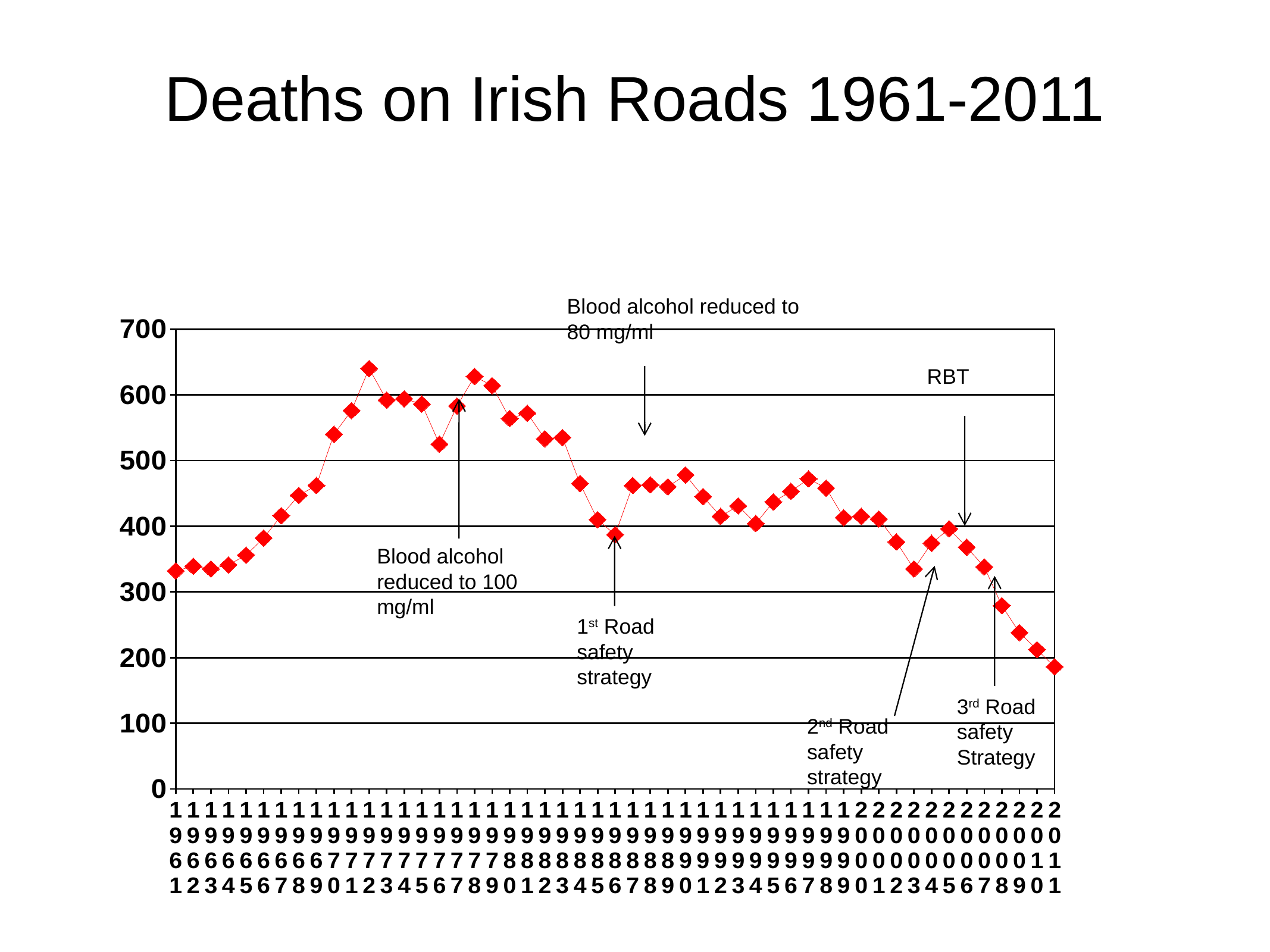
Is the value for 1972 greater or less than 600? greater Which year has the higher value, 1976 or 1978? 1978 Is the value for 1980 greater or less than 500? greater Which annotation on the chart points to the year 2006? RBT What is the title of the chart? Deaths on Irish Roads 1961-2011 Is the value for 2011 greater or less than 300? less Do the values rise or fall between 2005 and 2011? fall How many yearly data points are plotted on the chart? 51 Which year has the lowest number of deaths on the chart? 2011 What kind of chart is shown on the slide? line chart